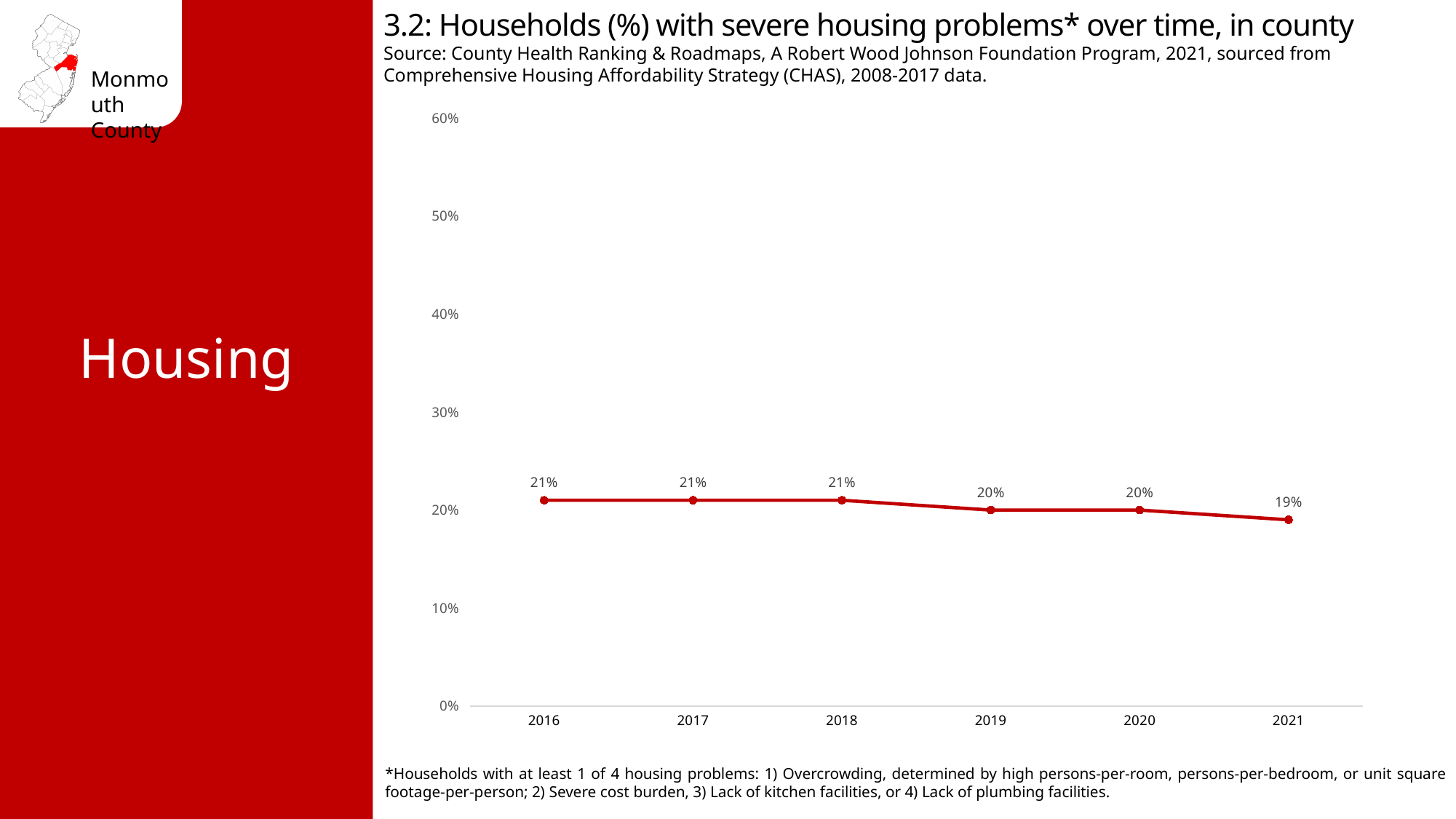
What kind of chart is shown on the slide? line chart What is the difference between the 2016 value and the 2021 value? 2 percentage points Which year has the lowest percentage of households with severe housing problems? 2021 What is the title of the chart? 3.2: Households (%) with severe housing problems* over time, in county Do the values rise or fall from 2016 to 2021? fall Is the value for 2018 larger or smaller than the value for 2020? larger What is the value shown for 2019? 20% What is the highest value shown on the y axis? 60% Is the value for 2021 greater or less than 20%? less What percentage of households had severe housing problems in 2016? 21% What is the value shown for 2021? 19% How many years are plotted on the chart? 6